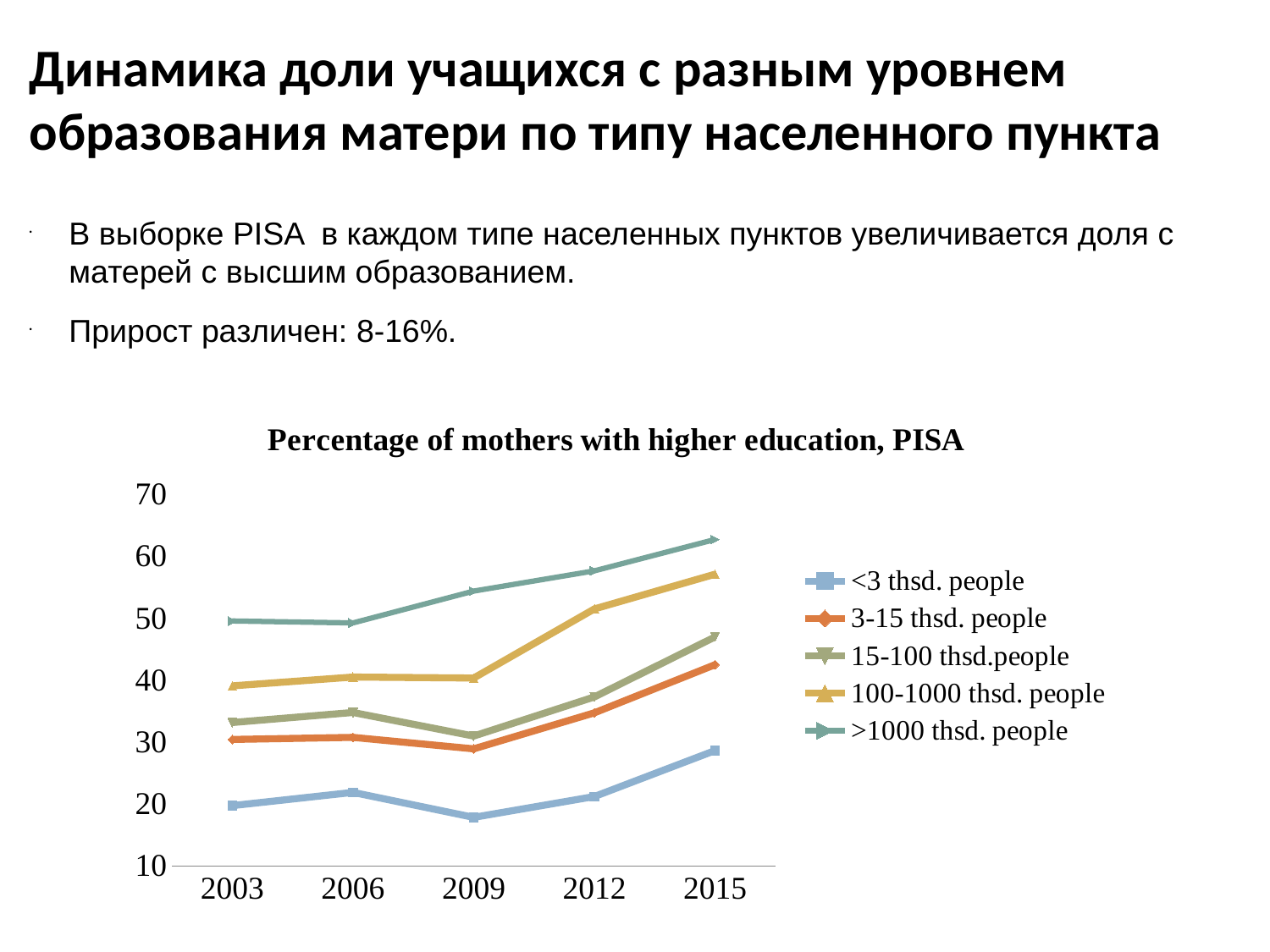
Which series has the highest value in 2015? >1000 thsd. people What kind of chart is shown on the slide? line chart How many years are shown on the x axis? 5 How many series does the legend list? 5 Is the value for 100-1000 thsd. people in 2012 greater or less than 50? greater Is the value for <3 thsd. people in 2009 greater or less than 20? less Is the value for >1000 thsd. people in 2015 greater or less than 60? greater What is the title of the chart? Percentage of mothers with higher education, PISA In 2012, which is larger: the value for 100-1000 thsd. people or for 15-100 thsd.people? 100-1000 thsd. people Does the value for <3 thsd. people rise or fall from 2009 to 2015? rise Which series has the lowest value in 2009? <3 thsd. people